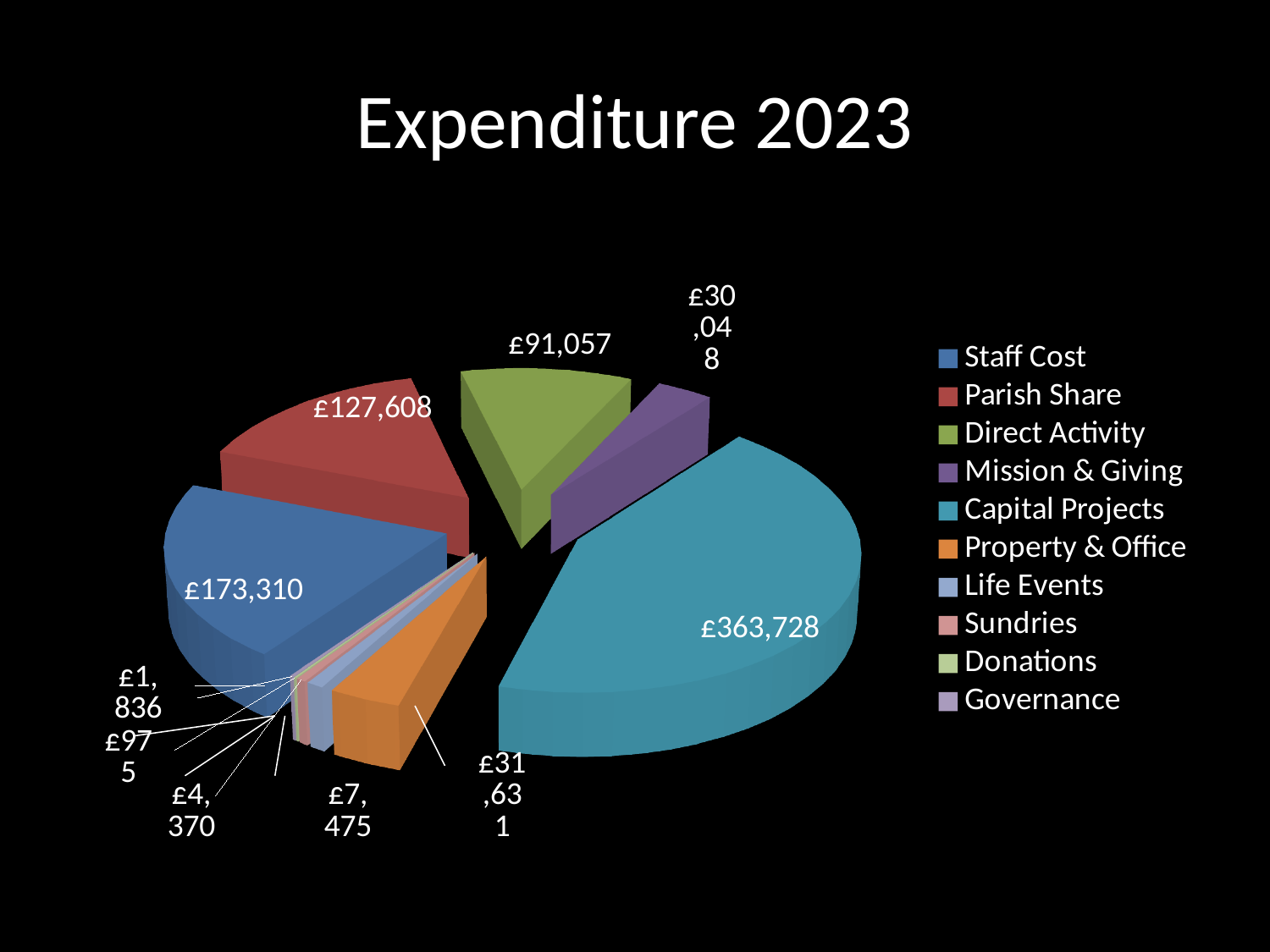
What is the value of the Staff Cost slice? £173,310 What is the value of the Direct Activity slice? £91,057 What is the value of the Property & Office slice? £31,631 How many categories does the legend list? 10 What is the difference between Staff Cost and Parish Share? £45,702 What is the value of the Parish Share slice? £127,608 What type of chart is shown on the slide? Pie chart What is the value of the Capital Projects slice? £363,728 Which category has the largest expenditure? Capital Projects Which is larger, Staff Cost or Parish Share? Staff Cost What is the value of the Mission & Giving slice? £30,048 What is the difference between Capital Projects and Staff Cost? £190,418